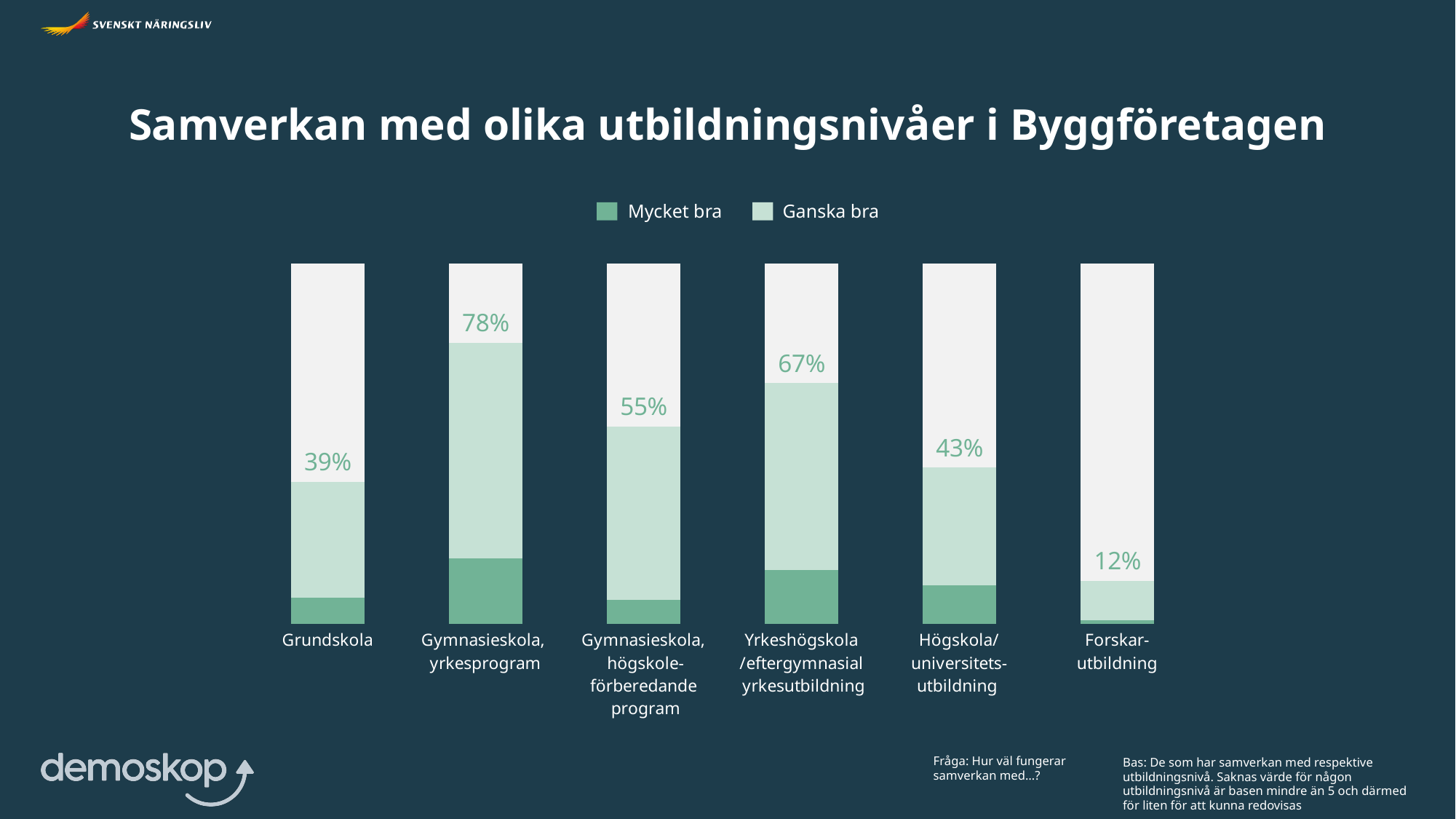
How many series does the legend list? 2 What is the combined value shown for Forskarutbildning? 12% What is the combined value shown for Yrkeshögskola/eftergymnasial yrkesutbildning? 67% What is the combined value shown for Grundskola? 39% Which education level has the highest combined value? Gymnasieskola, yrkesprogram What is the difference between the combined values for Gymnasieskola, yrkesprogram and Högskola/universitetsutbildning? 35 percentage points What kind of chart is shown on the slide? Stacked bar chart Which has a larger combined value: Gymnasieskola, högskoleförberedande program or Yrkeshögskola/eftergymnasial yrkesutbildning? Yrkeshögskola/eftergymnasial yrkesutbildning What is the combined value shown for Gymnasieskola, yrkesprogram? 78% What are the two series named in the legend? Mycket bra and Ganska bra How many education levels are shown on the chart? 6 Which education level has the lowest combined value? Forskarutbildning